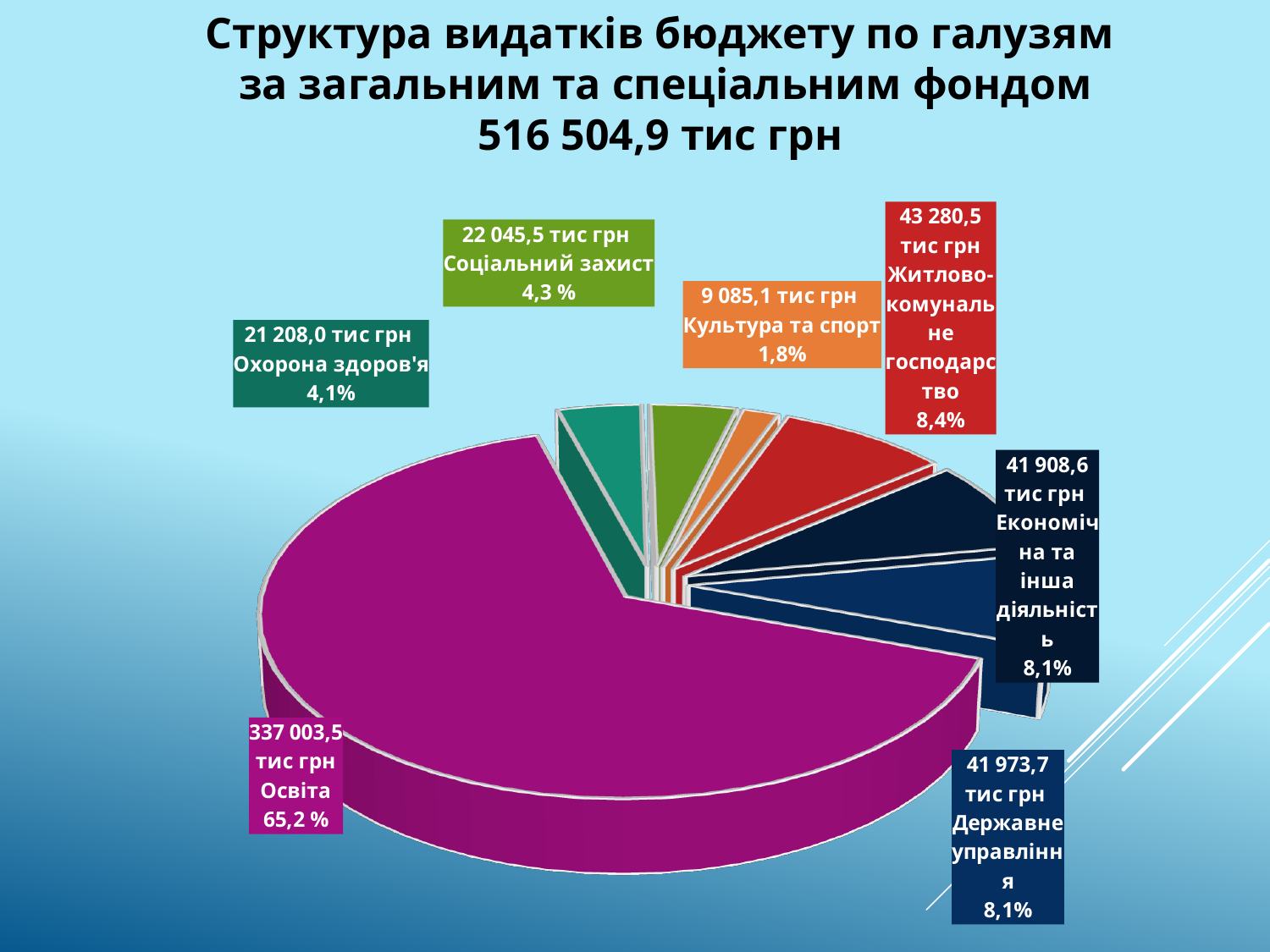
Which category has the smallest slice? Культура та спорт What is the difference in percentage points between the shares of Освіта and Житлово-комунальне господарство? 56,8 Which category has the largest slice? Освіта What share of the pie does Освіта take? 65,2 % What is the difference between the values for Житлово-комунальне господарство and Економічна та інша діяльність? 1 371,9 тис грн What total amount is stated in the chart title? 516 504,9 тис грн What is the value for Освіта? 337 003,5 тис грн How many slices does the pie chart have? 7 What is the value for Житлово-комунальне господарство? 43 280,5 тис грн Which is larger, the value for Соціальний захист or for Охорона здоров'я? Соціальний захист What kind of chart is shown on the slide? pie chart What percentage is shown for Культура та спорт? 1,8%